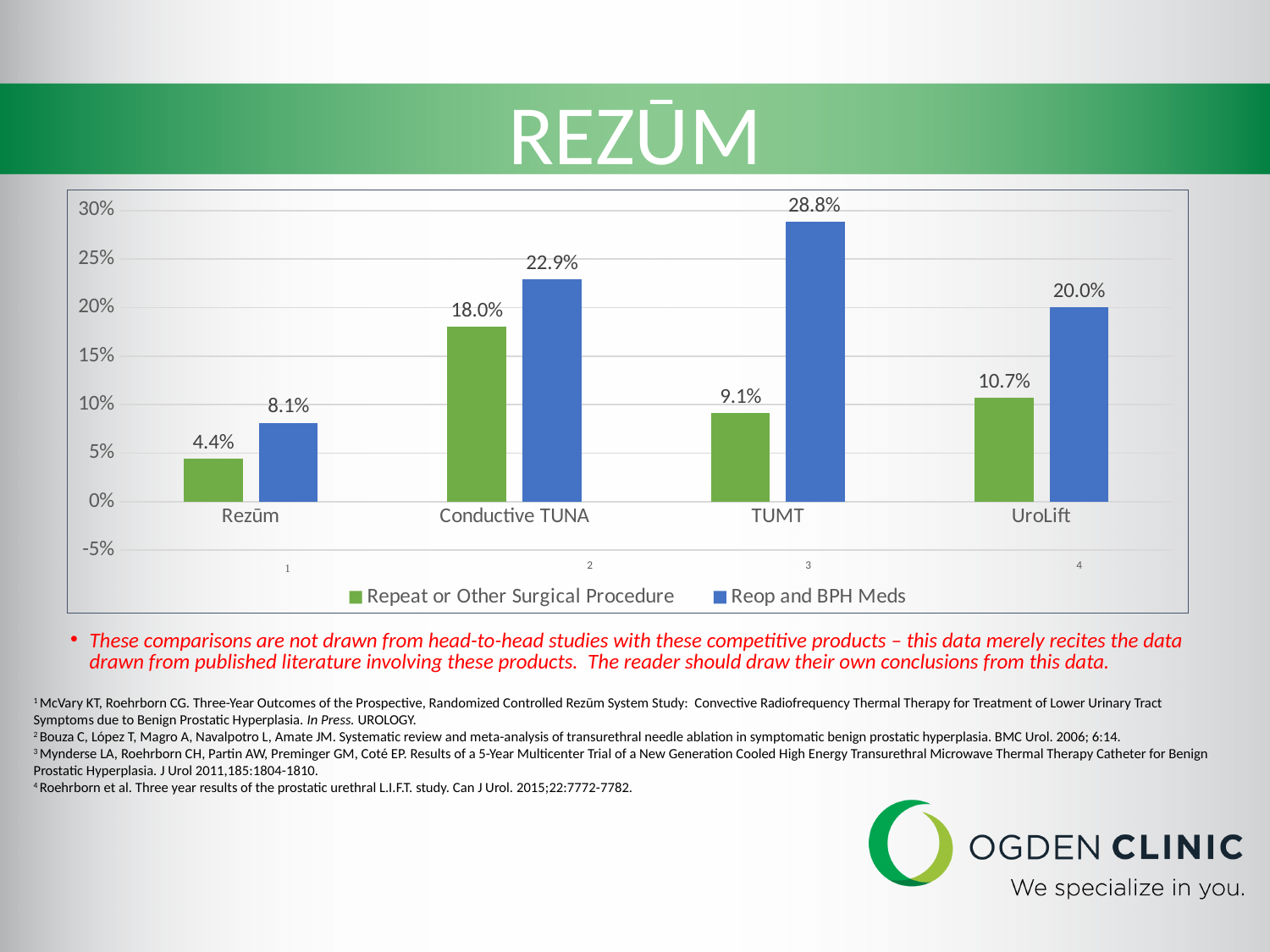
Which category has the lowest value in the Repeat or Other Surgical Procedure series? Rezūm Is the Reop and BPH Meds value for UroLift greater or less than 15%? greater Which is larger: the Repeat or Other Surgical Procedure value for Conductive TUNA or for UroLift? Conductive TUNA What kind of chart is shown on the slide? Bar chart How many categories are shown on the x axis? 4 What is the value for UroLift in the Repeat or Other Surgical Procedure series? 10.7% What colour are the bars for the Reop and BPH Meds series? Blue What is the value for Rezūm in the Repeat or Other Surgical Procedure series? 4.4% Which category has the highest value in the Reop and BPH Meds series? TUMT What is the value for TUMT in the Reop and BPH Meds series? 28.8% What is the difference between the Reop and BPH Meds value and the Repeat or Other Surgical Procedure value for Conductive TUNA? 4.9% How many series does the legend list? 2